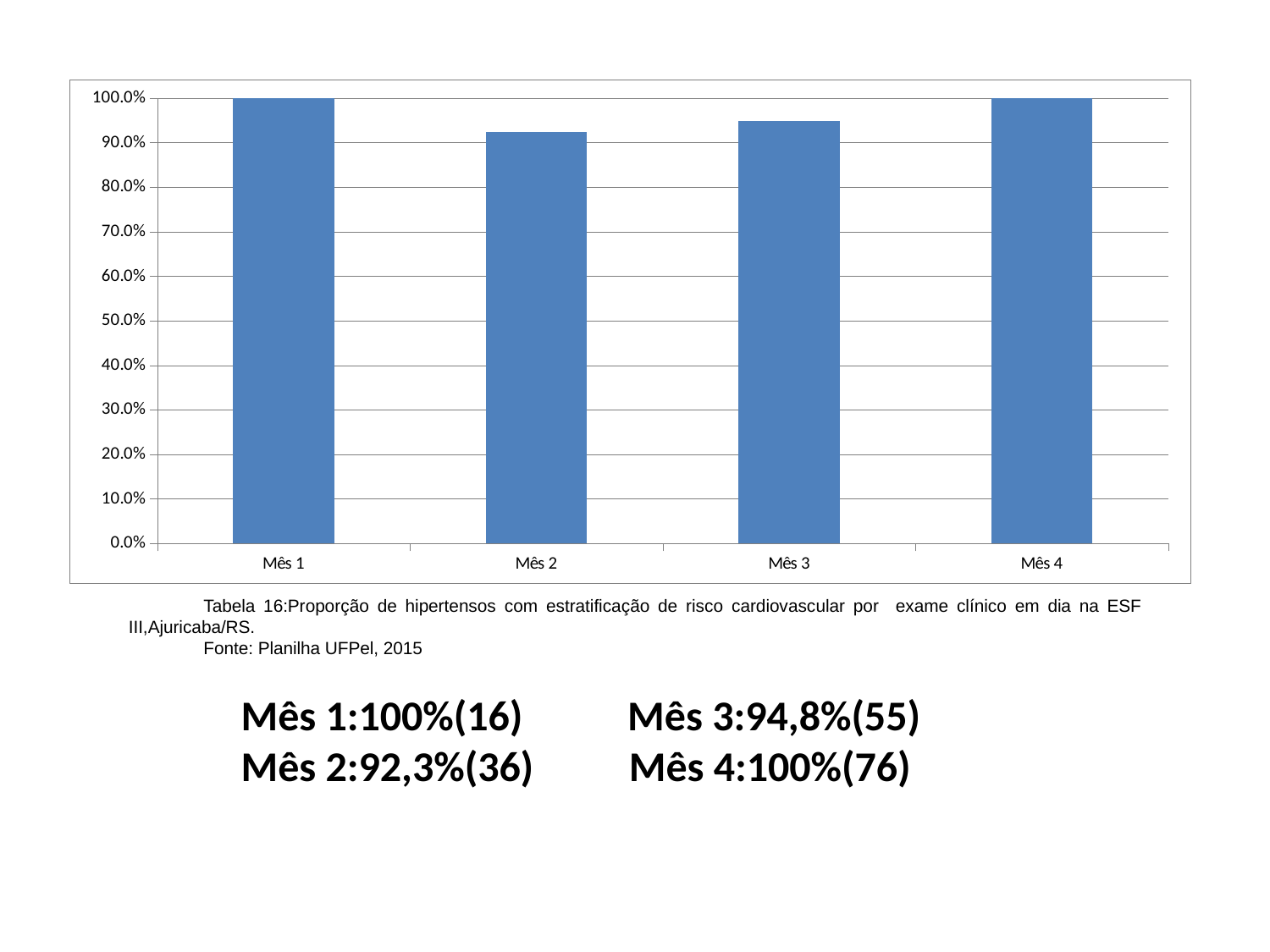
What is the value for Mês 3? 94,8% What source is cited below the chart? Planilha UFPel, 2015 What kind of chart is shown on the slide? bar chart What is the difference between the values for Mês 3 and Mês 2? 2,5 percentage points How many months are shown on the x axis? 4 Is the value for Mês 3 greater or less than 100.0%? less Which month has the lowest value? Mês 2 Is the value for Mês 2 greater or less than 90.0%? greater What is the value for Mês 2? 92,3% From Mês 2 to Mês 4, do the values rise or fall? rise Which is larger, the value for Mês 2 or the value for Mês 3? Mês 3 What is the value for Mês 1? 100%